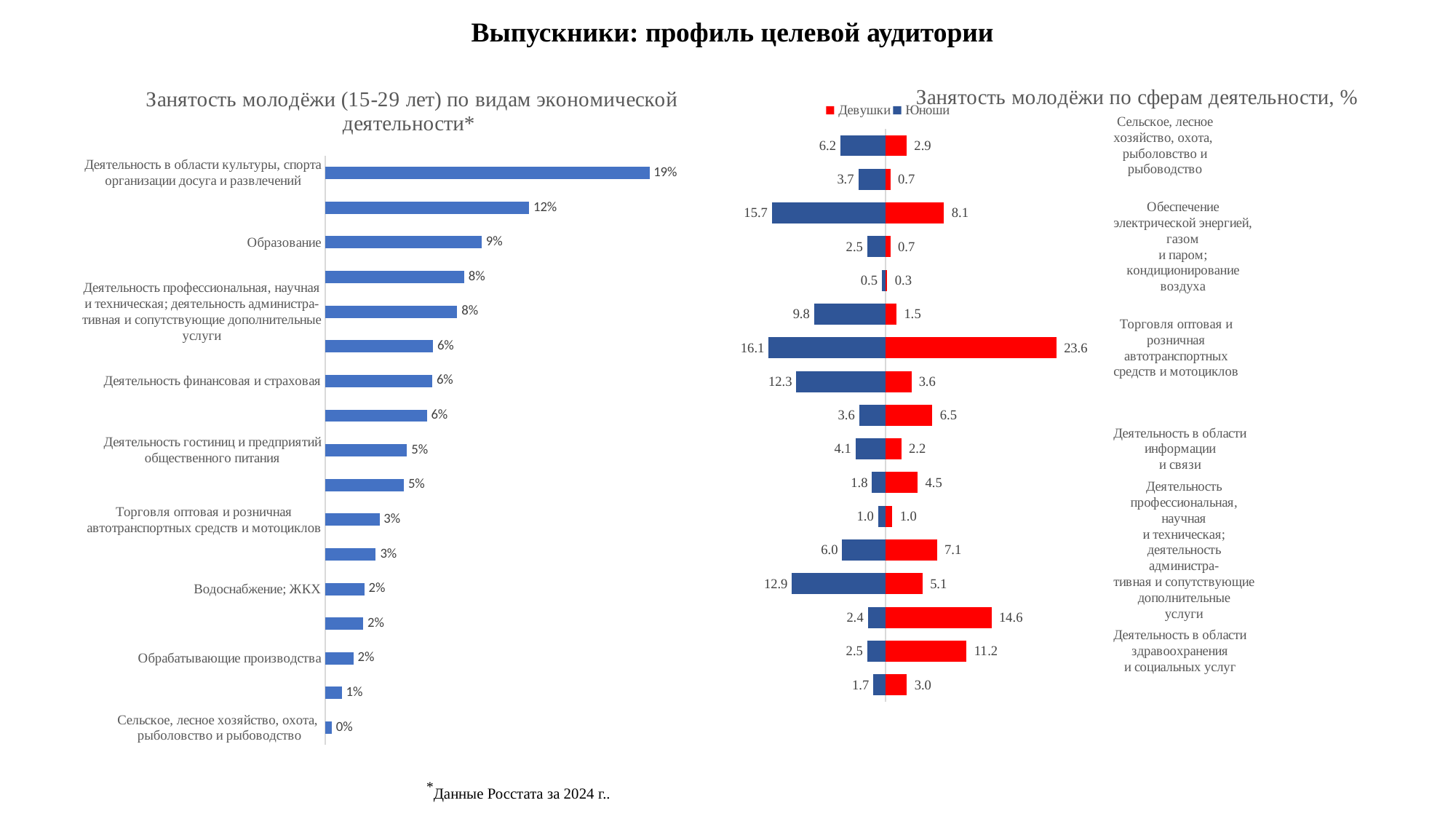
In the left chart, which is larger: the value for Деятельность финансовая и страховая or for Деятельность гостиниц и предприятий общественного питания? Деятельность финансовая и страховая How many bars are plotted in the left chart? 17 In the left chart, what is the value for Деятельность в области культуры, спорта, организации досуга и развлечений? 19% In the right chart, what is the highest value shown for the Юноши series? 16.1 In the left chart, what is the difference between the values for Образование and Водоснабжение; ЖКХ? 7% In the right chart, what colour represents the Девушки series? Red In the left chart, which category has the lowest value? Сельское, лесное хозяйство, охота, рыболовство и рыбоводство In the left chart (Занятость молодёжи (15-29 лет) по видам экономической деятельности), what is the value for Образование? 9% How many series does the legend of the right chart (Занятость молодёжи по сферам деятельности, %) list? 2 What kind of chart is the left chart? Bar chart In the left chart, which category has the highest value? Деятельность в области культуры, спорта, организации досуга и развлечений In the right chart, what is the highest value shown for the Девушки series? 23.6